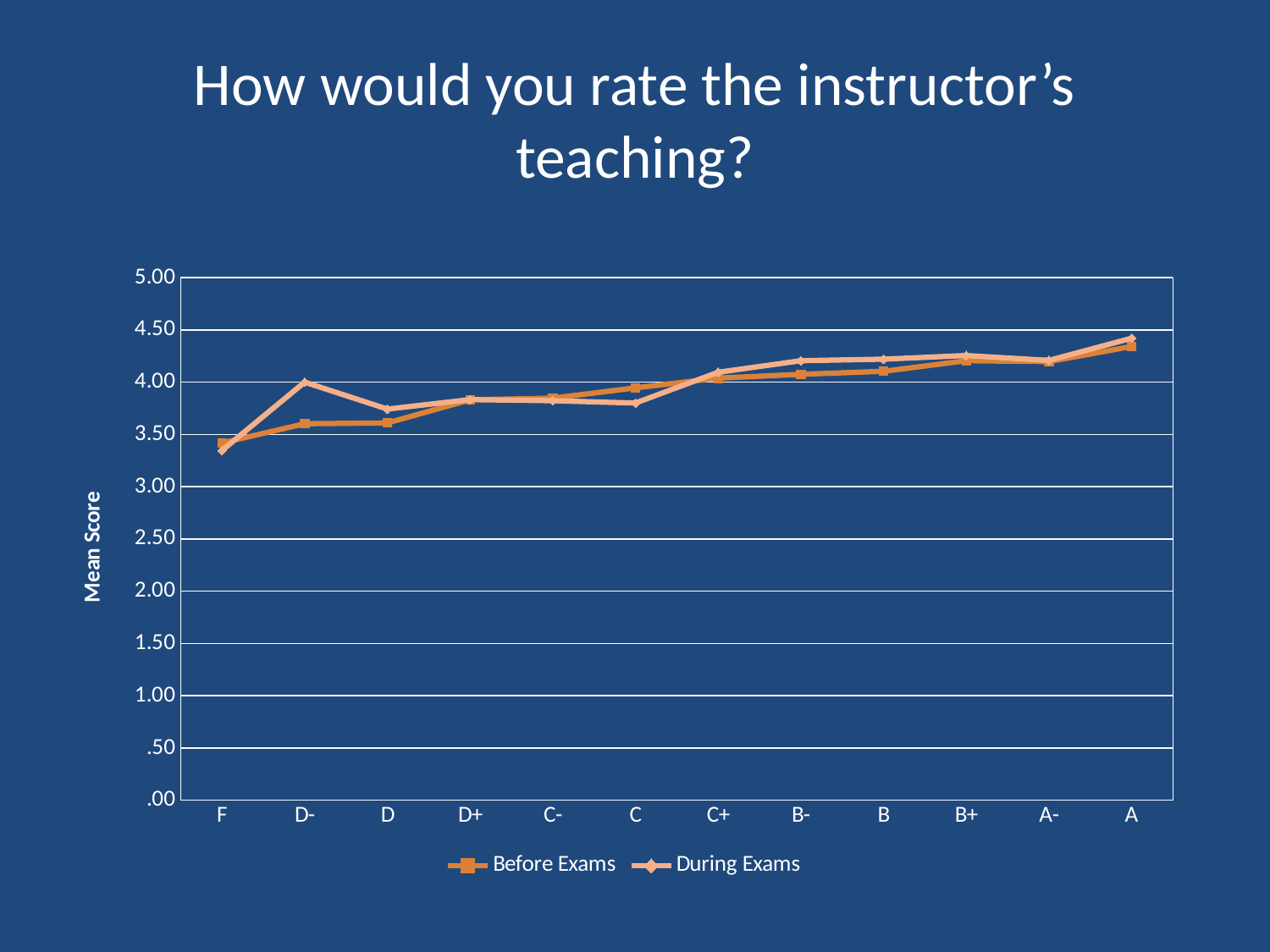
What is the label of the vertical axis? Mean Score Is the Before Exams value for F greater or less than 3.50? less What kind of chart is shown on the slide? Line chart At grade D-, which series has the higher mean score, Before Exams or During Exams? During Exams For which grade is the During Exams mean score lowest? F Is the Before Exams value for A greater or less than 4.50? less Is the During Exams value for D- greater or less than 3.50? greater Does the Before Exams mean score generally rise or fall from F to A? rise How many grade categories are shown along the x axis? 12 For which grade is the Before Exams mean score highest? A How many series does the legend list? 2